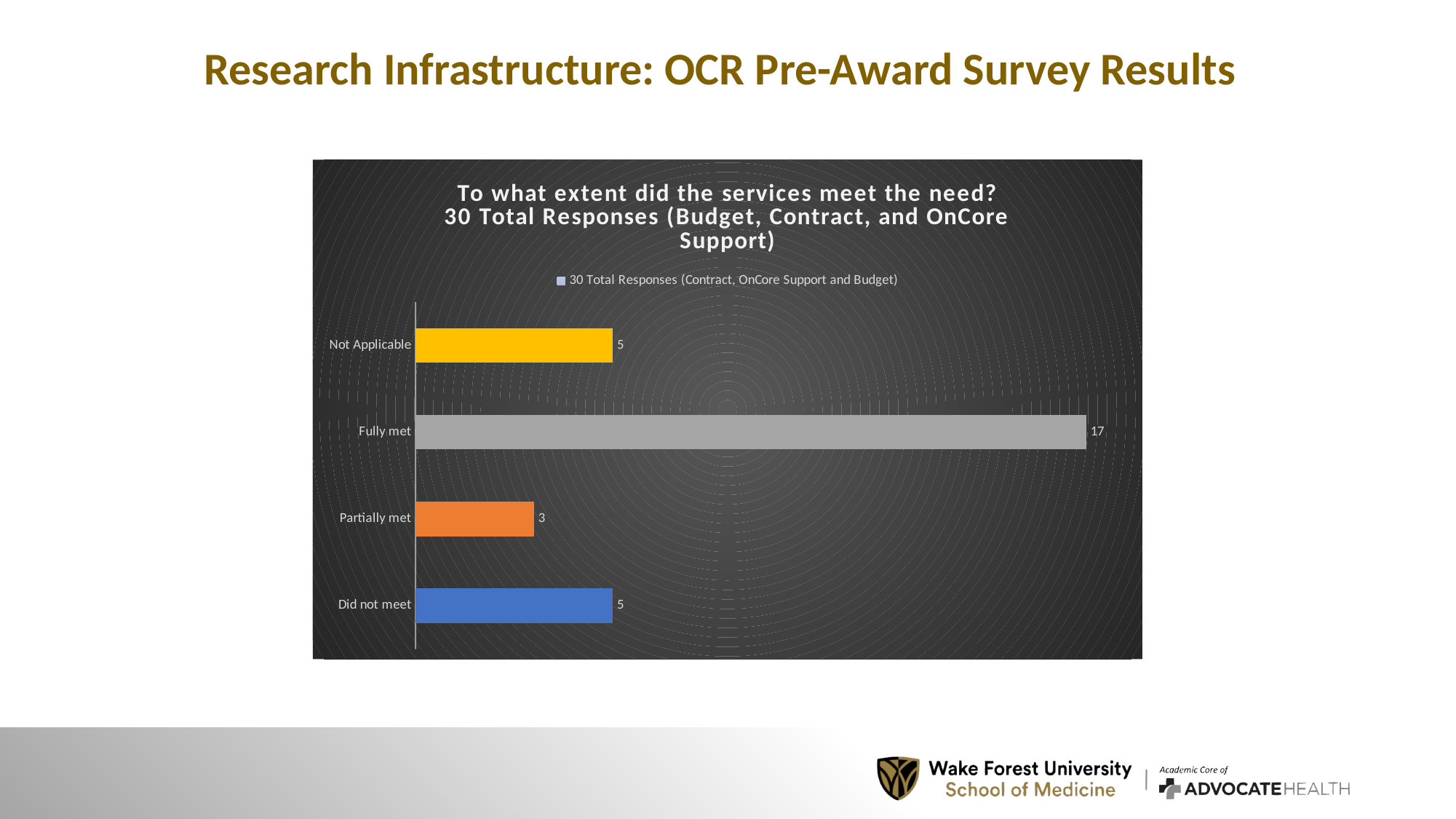
What is the difference between the values for Fully met and Did not meet? 12 Which is larger, the value for Did not meet or the value for Partially met? Did not meet Which category has the lowest value? Partially met What is the value for Fully met? 17 What is the value for Not Applicable? 5 How many series does the legend list? 1 What is the difference between the values for Fully met and Partially met? 14 Which category has the highest value? Fully met What is the value for Did not meet? 5 What is the value for Partially met? 3 How many categories are shown in the chart? 4 What kind of chart is shown on the slide? Bar chart